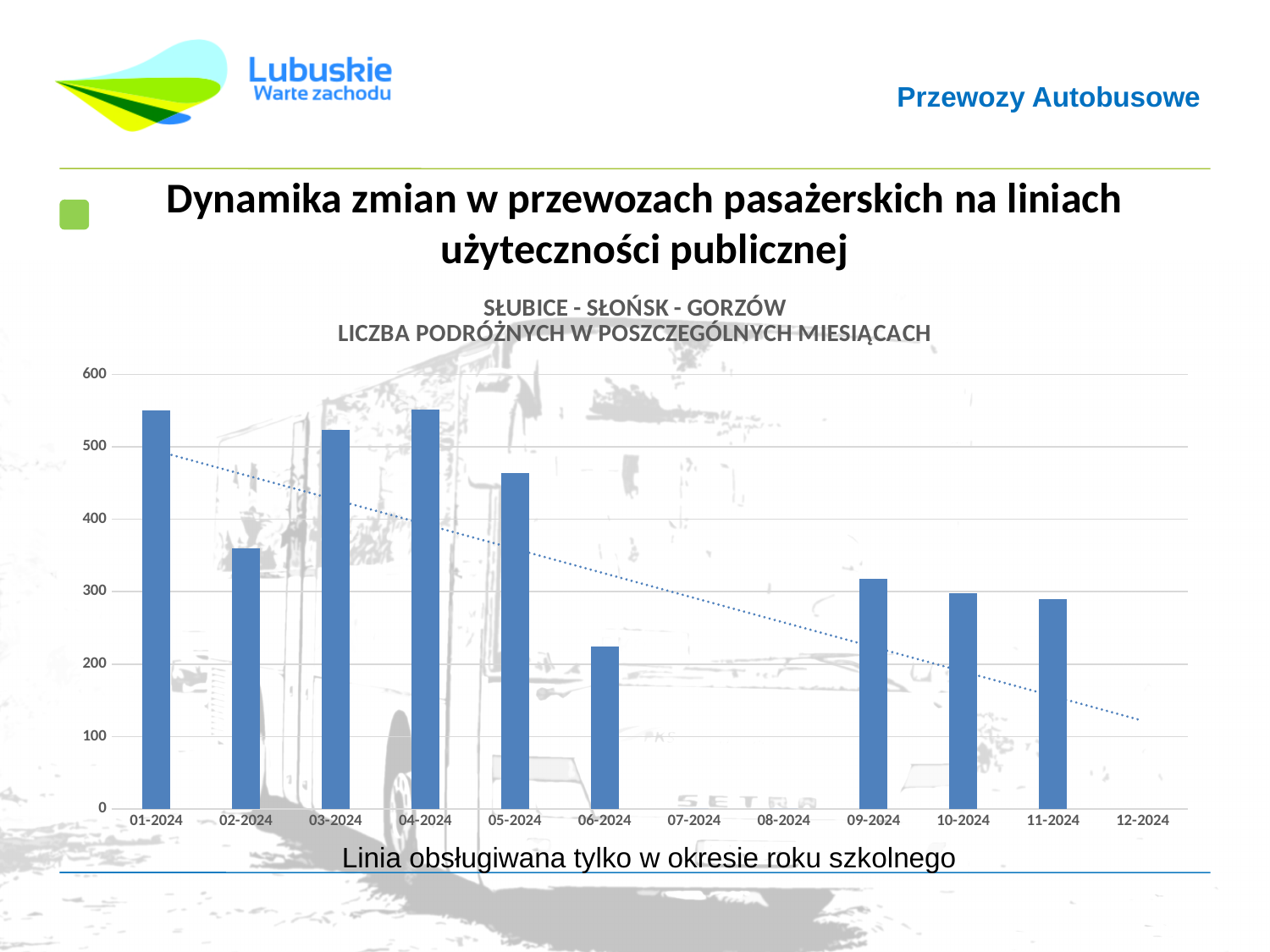
How many months are listed on the x axis? 12 Which month has the lowest number of passengers among the months with a bar? 06-2024 Is the value for 06-2024 greater or less than 300? less Which is larger, the value for 02-2024 or the value for 03-2024? 03-2024 Is the value for 01-2024 greater or less than 500? greater Is the value for 05-2024 greater or less than 400? greater How many months have a bar plotted? 9 Does the dotted trend line rise or fall from left to right? fall What kind of chart is shown on the slide? bar chart Which is larger, the value for 06-2024 or the value for 10-2024? 10-2024